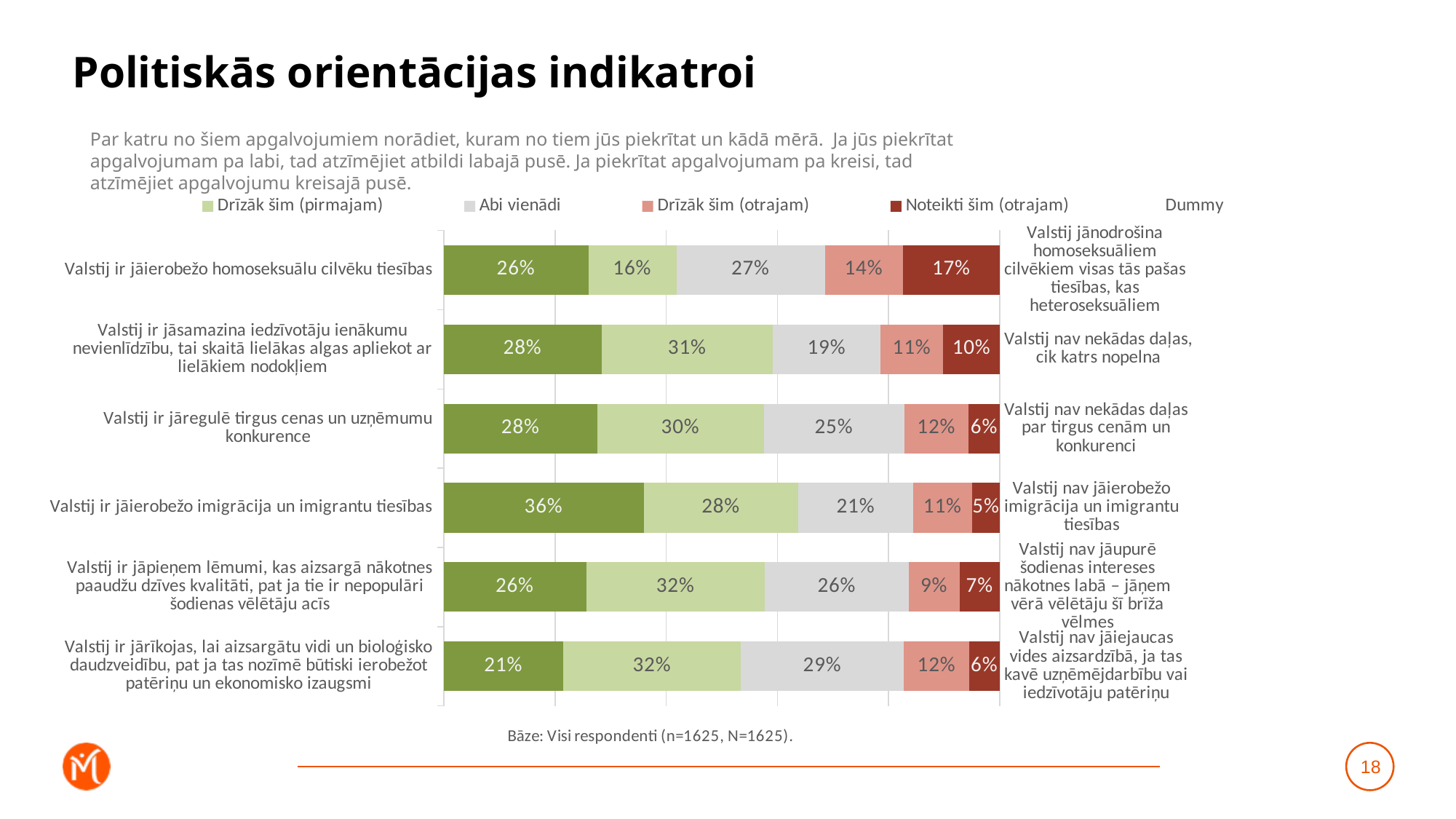
Which has the larger "Drīzāk šim (otrajam)" value: the statement about homosexual people's rights or the statement about future generations' quality of life? The statement about homosexual people's rights (14%) What is the "Noteikti šim (otrajam)" value for the statement "Valstij ir jāierobežo imigrācija un imigrantu tiesības"? 5% According to the base note under the chart, how many respondents were surveyed? n=1625 What type of chart is shown on the slide? Stacked horizontal bar chart Which statement has the lowest "Noteikti šim (otrajam)" share? Valstij ir jāierobežo imigrācija un imigrantu tiesības (5%) How many statements (bars) are shown in the chart? 6 How many percentage points higher is the "Drīzāk šim (pirmajam)" value for the environment statement ("Valstij ir jārīkojas, lai aizsargātu vidi...") than for the statement about homosexual people's rights? 16 percentage points Which statement has the highest "Abi vienādi" share? Valstij ir jārīkojas, lai aizsargātu vidi un bioloģisko daudzveidību... (29%) What percentage of respondents answered "Abi vienādi" for the statement "Valstij ir jāierobežo homoseksuālu cilvēku tiesības"? 27% What is the total of the labelled segments in the bar for "Valstij ir jāierobežo homoseksuālu cilvēku tiesības"? 100% What is the "Drīzāk šim (pirmajam)" value for the statement "Valstij ir jāsamazina iedzīvotāju ienākumu nevienlīdzību..."? 31% Which statement has the largest leftmost dark green segment? Valstij ir jāierobežo imigrācija un imigrantu tiesības (36%)